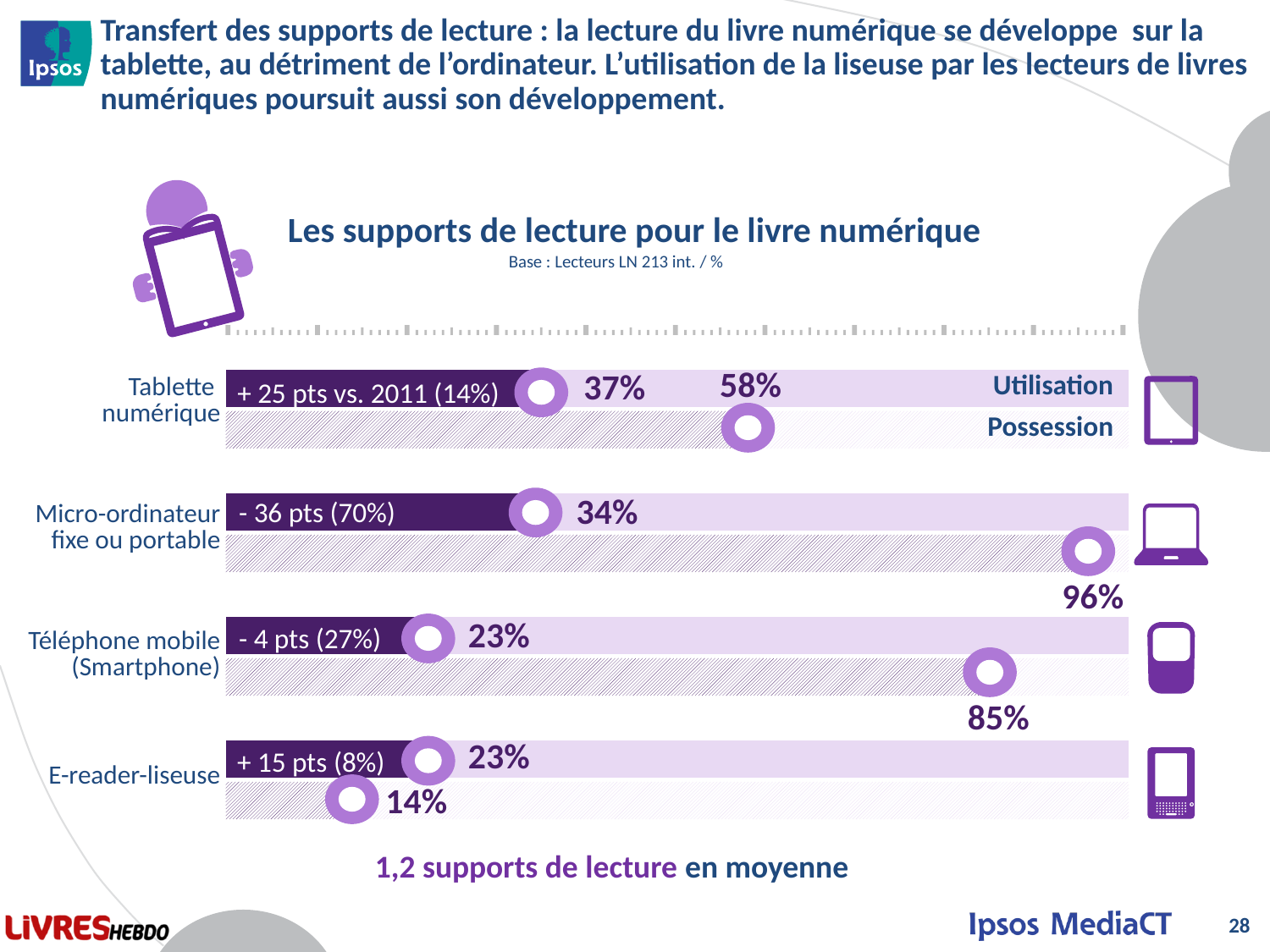
Which category has the highest Utilisation value? Tablette numérique What is the change in Utilisation for Tablette numérique versus 2011, as printed on the bar? + 25 pts vs. 2011 (14%) What kind of chart is shown on the slide? Bar chart How many series does the chart show? 2 What is the Possession value for Téléphone mobile (Smartphone)? 85% What is the Utilisation value for Tablette numérique? 37% What is the Possession value for E-reader-liseuse? 14% How many reading devices (categories) are shown in the chart? 4 Which is larger for E-reader-liseuse: Utilisation or Possession? Utilisation Which category has the lowest Possession value? E-reader-liseuse What is the Possession value for Micro-ordinateur fixe ou portable? 96% What is the difference between the Possession and Utilisation values for Micro-ordinateur fixe ou portable? 62 points